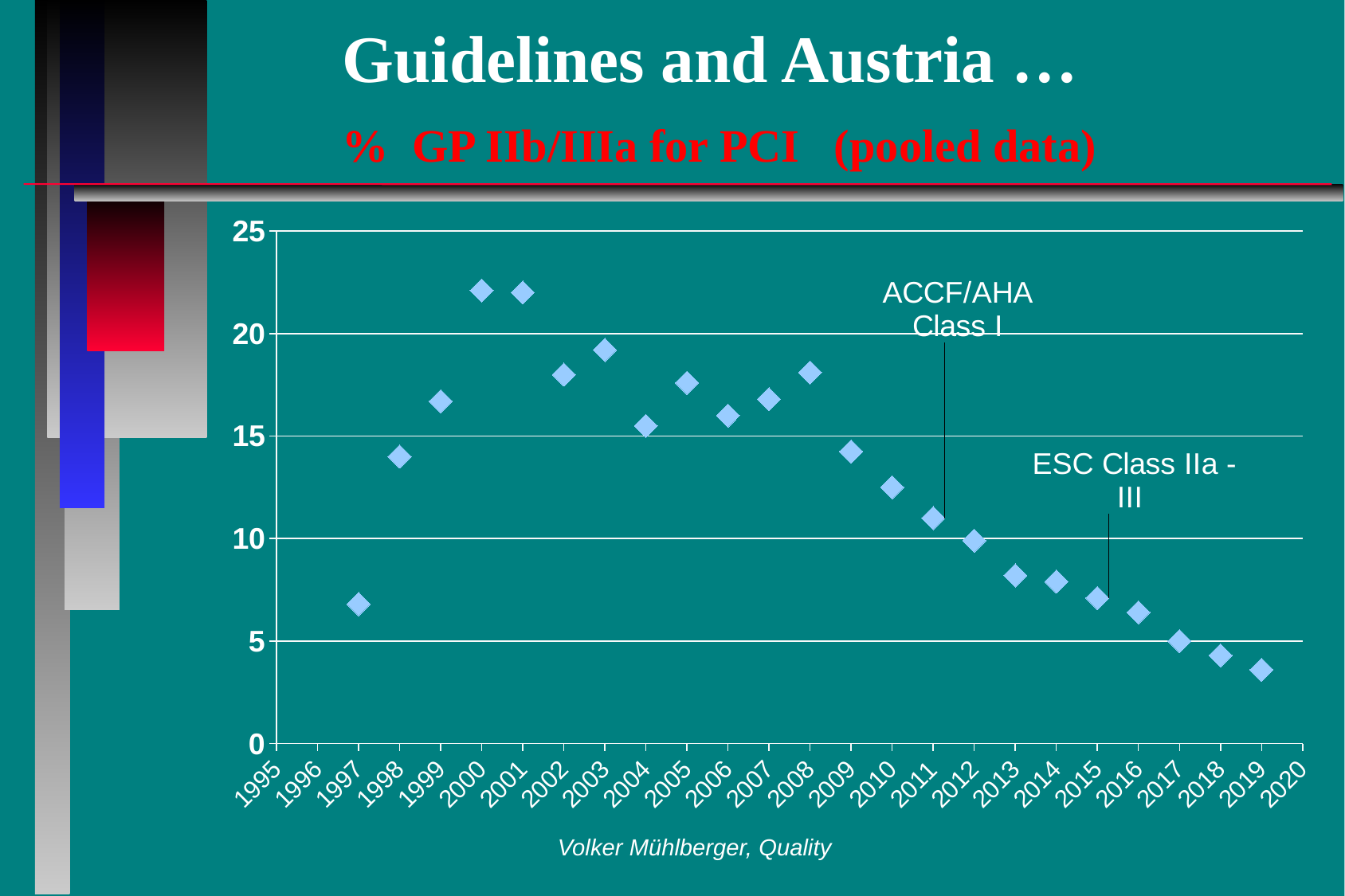
Is the value for 2013 greater or less than 10? less Is the value for 1997 greater or less than 10? less Which year has the larger value, 2008 or 2013? 2008 Which year has the larger value, 2003 or 2002? 2003 Which year has the lowest value on the chart? 2019 Which guideline annotation is marked at the year 2011 on the chart? ACCF/AHA Class I Is the value for 2009 greater or less than 15? less How many data points are plotted on the chart? 23 Do the values rise or fall from 2008 to 2019? fall What kind of chart is shown on the slide? scatter chart